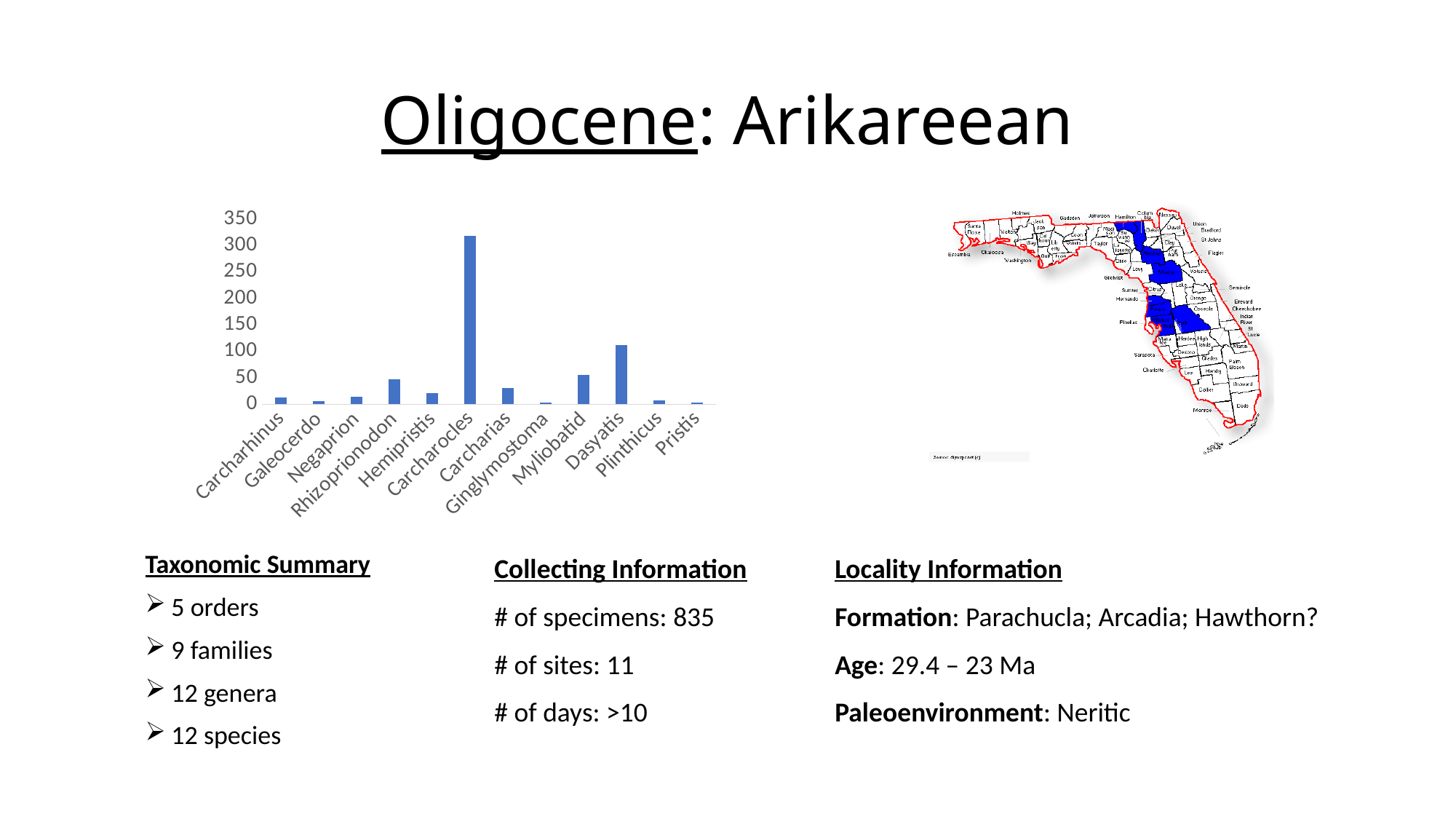
Is the value for Carcharias greater or less than 50? less Which has the larger value, Rhizoprionodon or Hemipristis? Rhizoprionodon Is the value for Myliobatid greater or less than 100? less Is the value for Rhizoprionodon greater or less than 100? less What kind of chart is shown on the slide? bar chart Which has the larger value, Carcharocles or Dasyatis? Carcharocles How many categories (taxa) are shown on the x axis of the bar chart? 12 Which taxon has the highest bar in the chart? Carcharocles What is the highest value labelled on the y axis of the chart? 350 Which has the larger value, Dasyatis or Myliobatid? Dasyatis